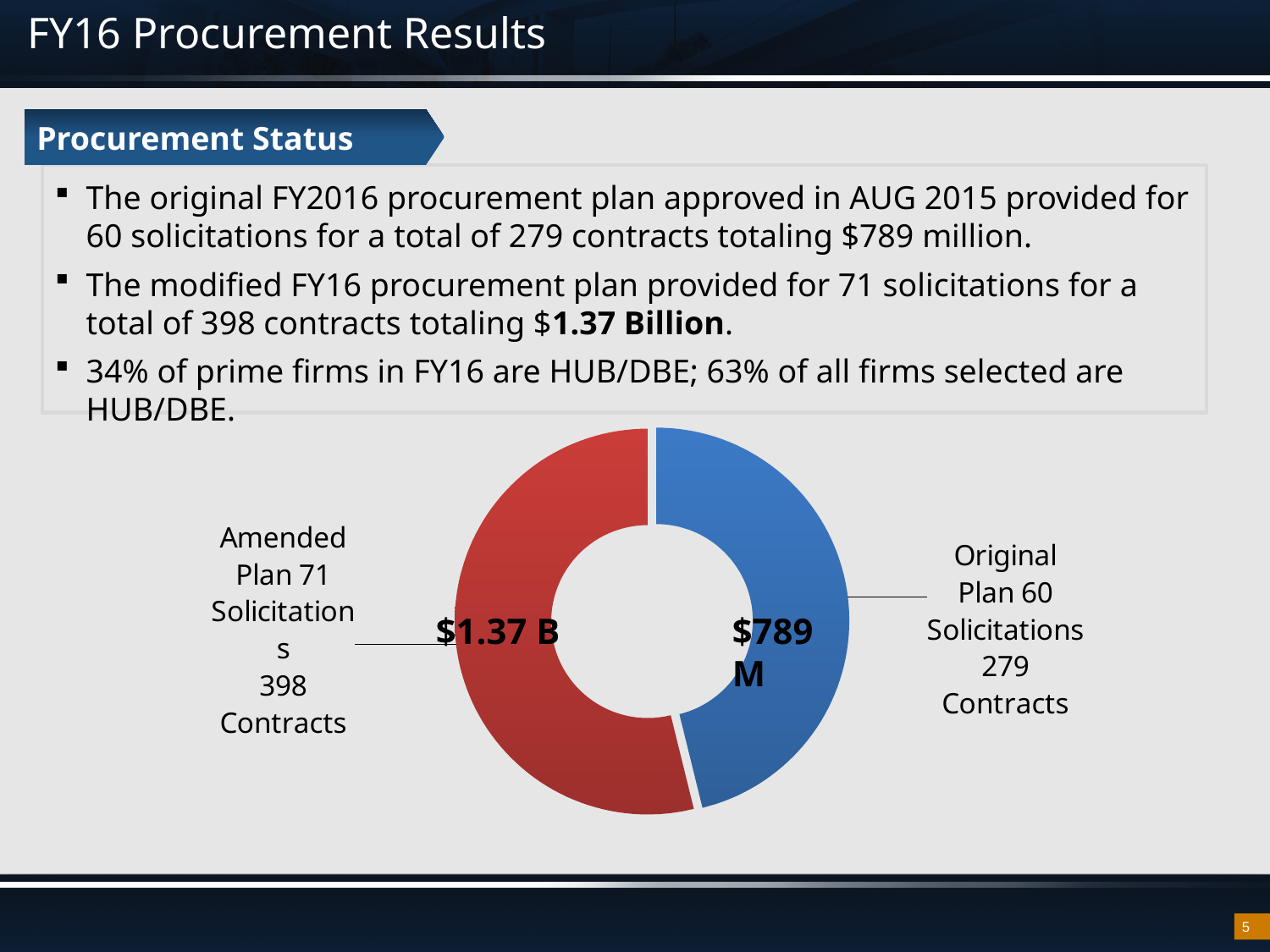
What colour is the Amended Plan slice in the doughnut chart? red How many solicitations does the Amended Plan label on the chart state? 71 What colour is the Original Plan slice in the doughnut chart? blue Is the Amended Plan value larger or smaller than the Original Plan value in the doughnut chart? larger How many slices does the doughnut chart have? 2 What value is shown for the Original Plan slice of the doughnut chart? $789 M How many contracts does the Amended Plan label on the chart state? 398 How many contracts does the Original Plan label on the chart state? 279 Which slice of the doughnut chart represents the smaller amount? Original Plan What value is shown for the Amended Plan slice of the doughnut chart? $1.37 B Which slice of the doughnut chart represents the larger amount? Amended Plan What type of chart is shown on the slide? doughnut chart